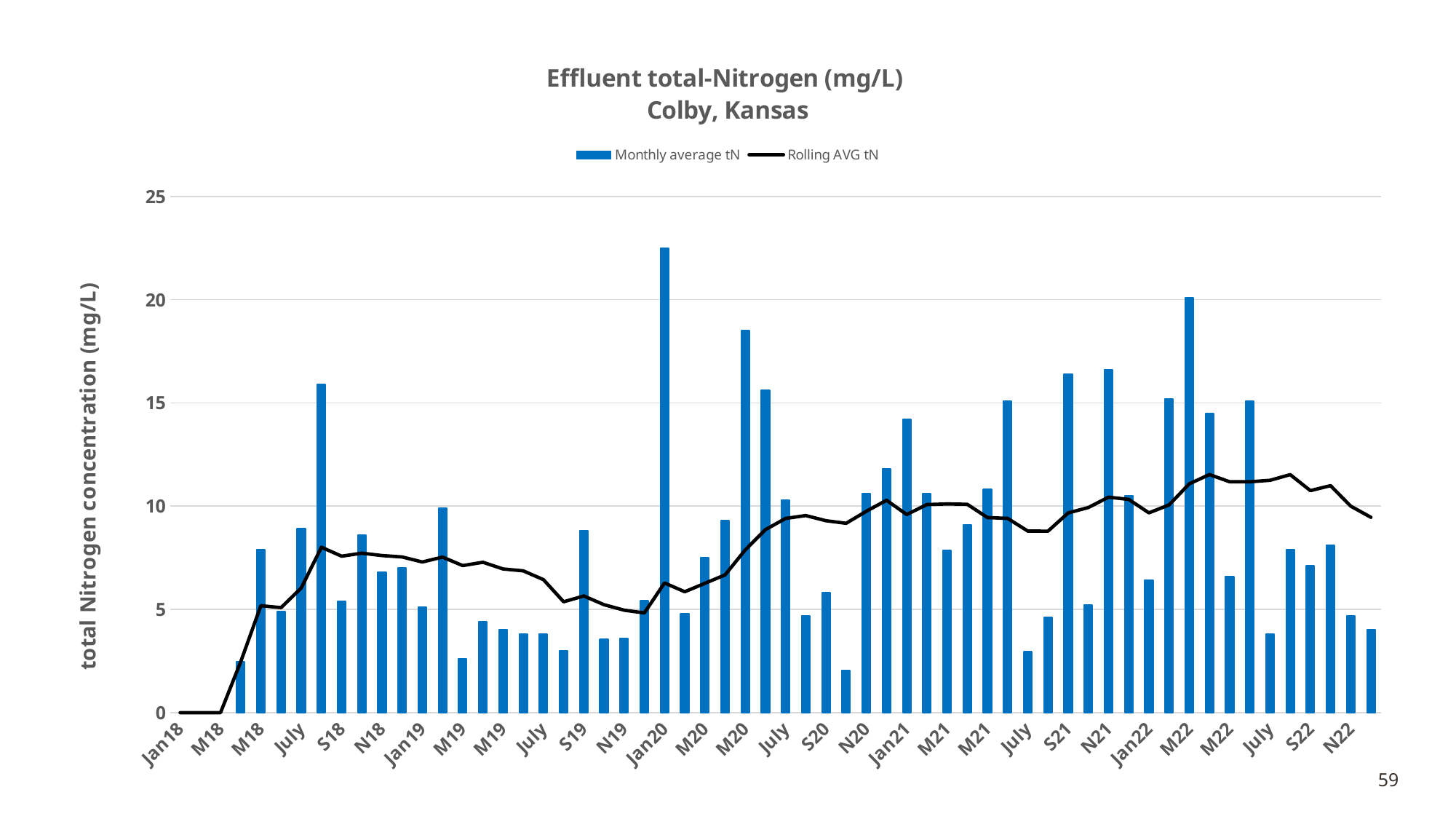
Is the Rolling AVG tN value at Jan20 greater or less than 5? greater Is the Monthly average tN value for S19 greater or less than 10? less Does the Rolling AVG tN line rise or fall between Jan18 and July 2018? Rise How many series does the legend list? 2 Which month has the highest Monthly average tN bar? Jan20 Which series is drawn as a black line? Rolling AVG tN What kind of chart is shown on the slide? A combined bar and line chart Which is larger, the Monthly average tN bar for S21 or the bar for July 2021? S21 Is the Monthly average tN value for Jan20 greater or less than 20? greater What is the title of the chart? Effluent total-Nitrogen (mg/L) Colby, Kansas